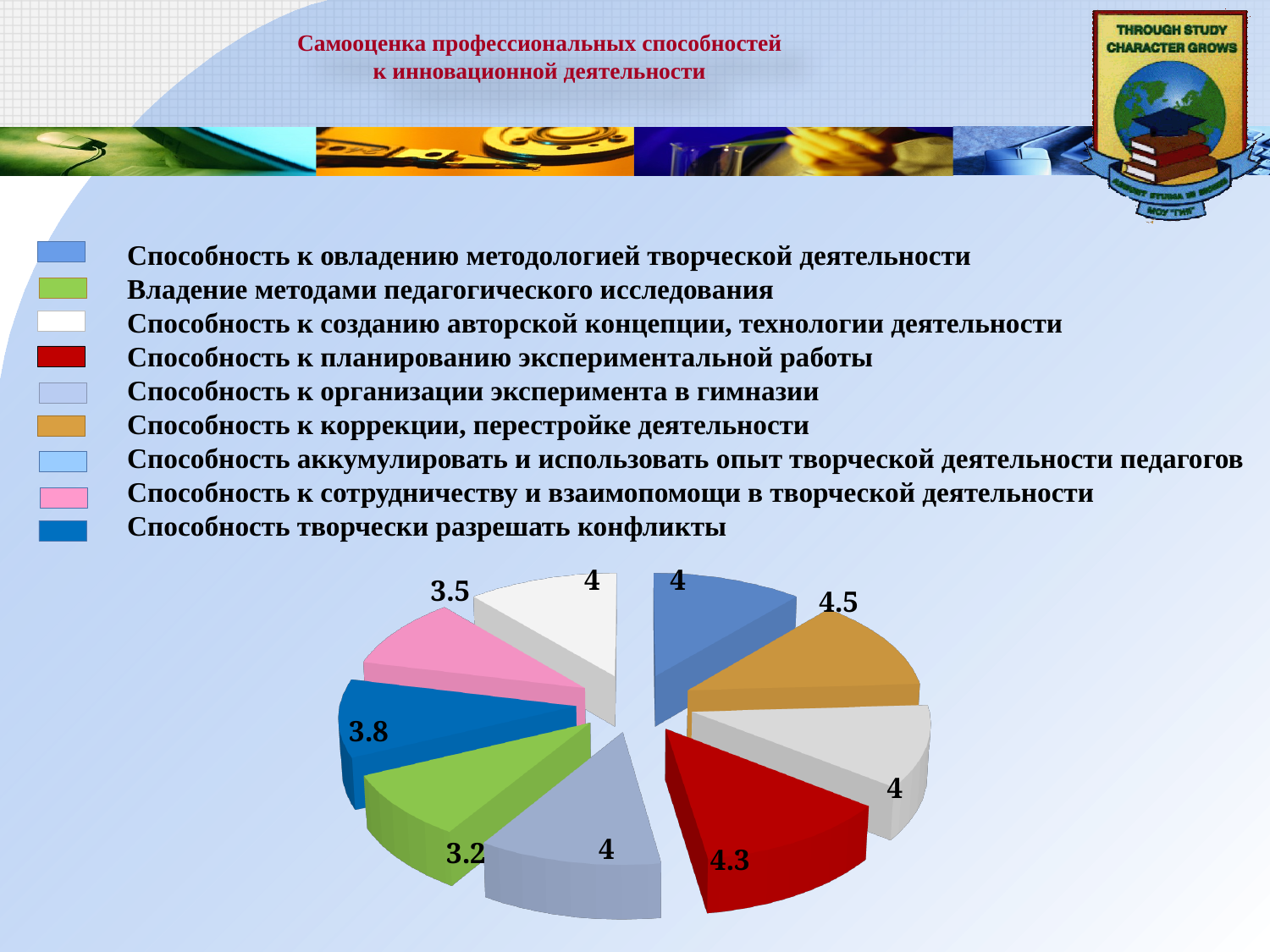
What is the title of the slide containing the pie chart? Самооценка профессиональных способностей к инновационной деятельности What is the value for "Способность к планированию экспериментальной работы"? 4.3 What is the value for "Способность к сотрудничеству и взаимопомощи в творческой деятельности"? 3.5 What kind of chart is shown on the slide? Pie chart What is the value for "Способность к коррекции, перестройке деятельности"? 4.5 How many slices does the pie chart have? 9 What is the difference between the highest value (4.5) and the lowest value (3.2) in the pie chart? 1.3 What is the value for "Способность творчески разрешать конфликты"? 3.8 Which category has the lowest value in the pie chart? Владение методами педагогического исследования Which category has the highest value in the pie chart? Способность к коррекции, перестройке деятельности Which is larger: the value for "Способность к планированию экспериментальной работы" or the value for "Способность к сотрудничеству и взаимопомощи в творческой деятельности"? Способность к планированию экспериментальной работы What is the value for "Владение методами педагогического исследования"? 3.2